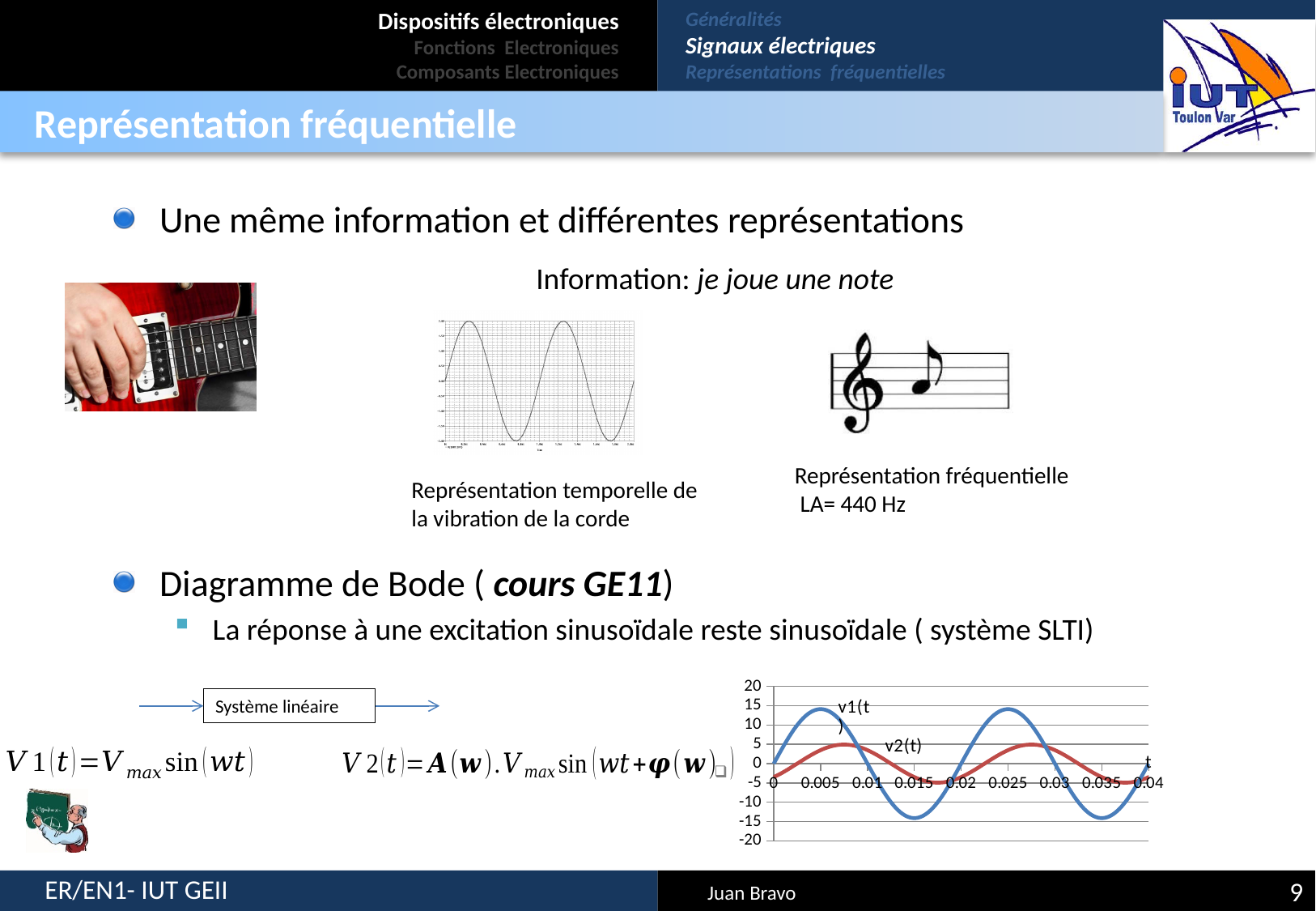
In the bottom-right chart, how many series are plotted? 2 In the bottom-right chart, is the minimum value of v1(t) greater or less than -10? less What is the largest value shown on the horizontal axis of the bottom-right chart? 0.04 In the bottom-right chart, is the minimum value of v2(t) greater or less than -10? greater In the bottom-right chart, what colour is the v1(t) curve? blue In the bottom-right chart, is the peak value of v2(t) greater or less than 10? less What is the highest tick value on the vertical axis of the bottom-right chart? 20 How many tick labels are shown on the horizontal axis of the bottom-right chart? 9 In the bottom-right chart, which series has the larger amplitude, v1(t) or v2(t)? v1(t) What kind of chart is shown at the bottom right of the slide? line chart